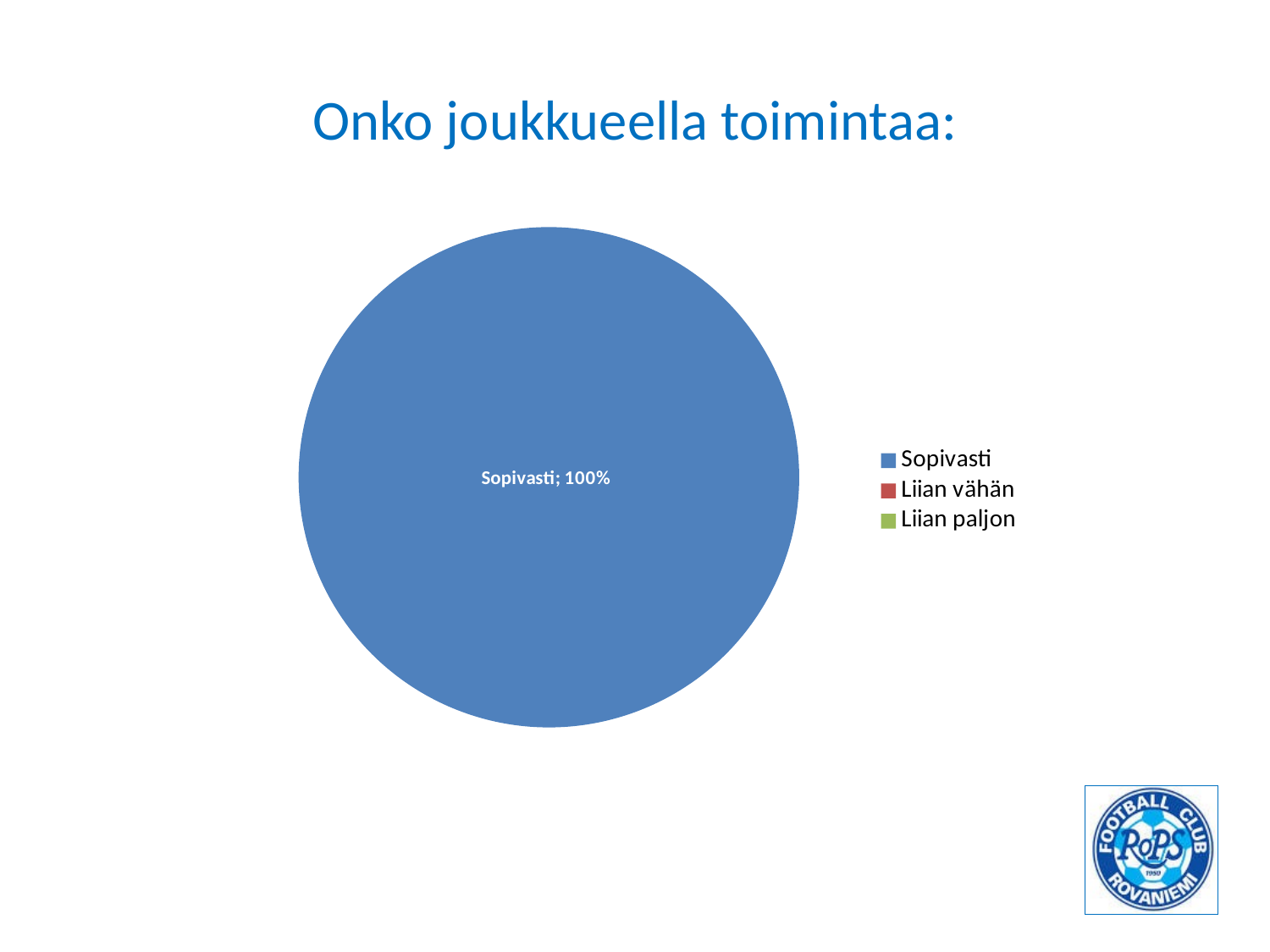
How many slices are visible in the pie chart? 1 What is the title of the slide above the chart? Onko joukkueella toimintaa: How many entries does the legend list? 3 Which category has the largest share of the pie? Sopivasti Which category is larger, Sopivasti or Liian vähän? Sopivasti What kind of chart is shown on the slide? pie chart Which category is larger, Sopivasti or Liian paljon? Sopivasti What share of the pie does the Sopivasti slice represent? 100% What is the value printed on the Sopivasti slice? 100% What colour is the Sopivasti slice? blue